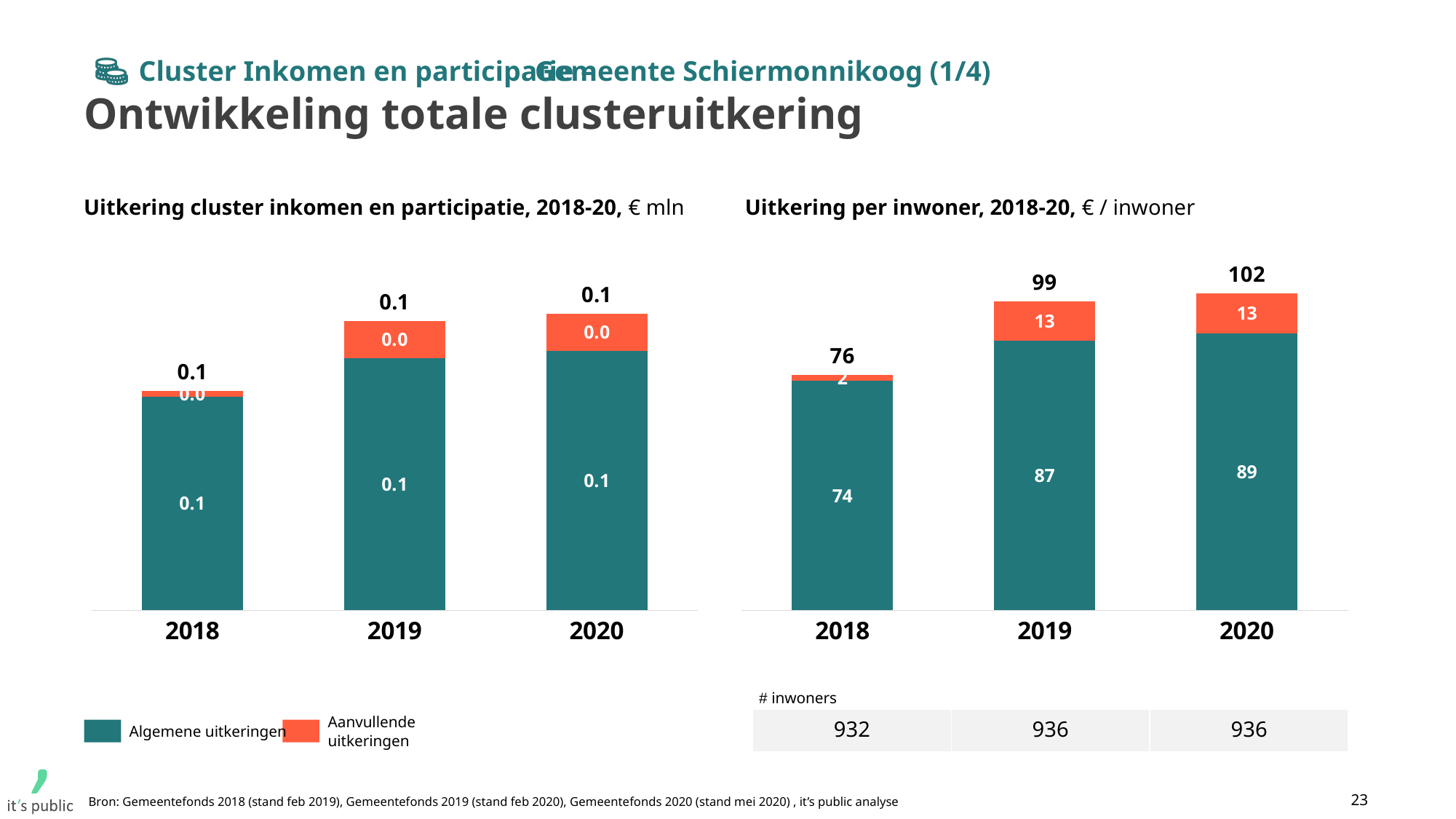
In the 'Uitkering per inwoner' chart, do the total values rise or fall from 2018 to 2020? rise In the 'Uitkering per inwoner' chart, what is the value for Aanvullende uitkeringen in 2018? 2 In the 'Uitkering per inwoner' chart, what is the value for Algemene uitkeringen in 2019? 87 In the 'Uitkering cluster inkomen en participatie' chart, what is the value for Algemene uitkeringen in 2020? 0.1 What kind of chart is the 'Uitkering per inwoner, 2018-20' chart? stacked bar chart How many years are shown on the x axis of the 'Uitkering cluster inkomen en participatie' chart? 3 In the 'Uitkering per inwoner' chart, which year has the lowest total uitkering per inwoner? 2018 How many series does the legend of the 'Uitkering cluster inkomen en participatie' chart list? 2 In the 'Uitkering per inwoner' chart, what is the total of the stacked bar for 2020? 102 In the 'Uitkering per inwoner' chart, which year has the highest total uitkering per inwoner? 2020 In the 'Uitkering per inwoner' chart, is the Algemene uitkeringen value larger in 2019 or in 2020? 2020 In the 'Uitkering per inwoner' chart, what is the difference between the Algemene uitkeringen values for 2020 and 2018? 15